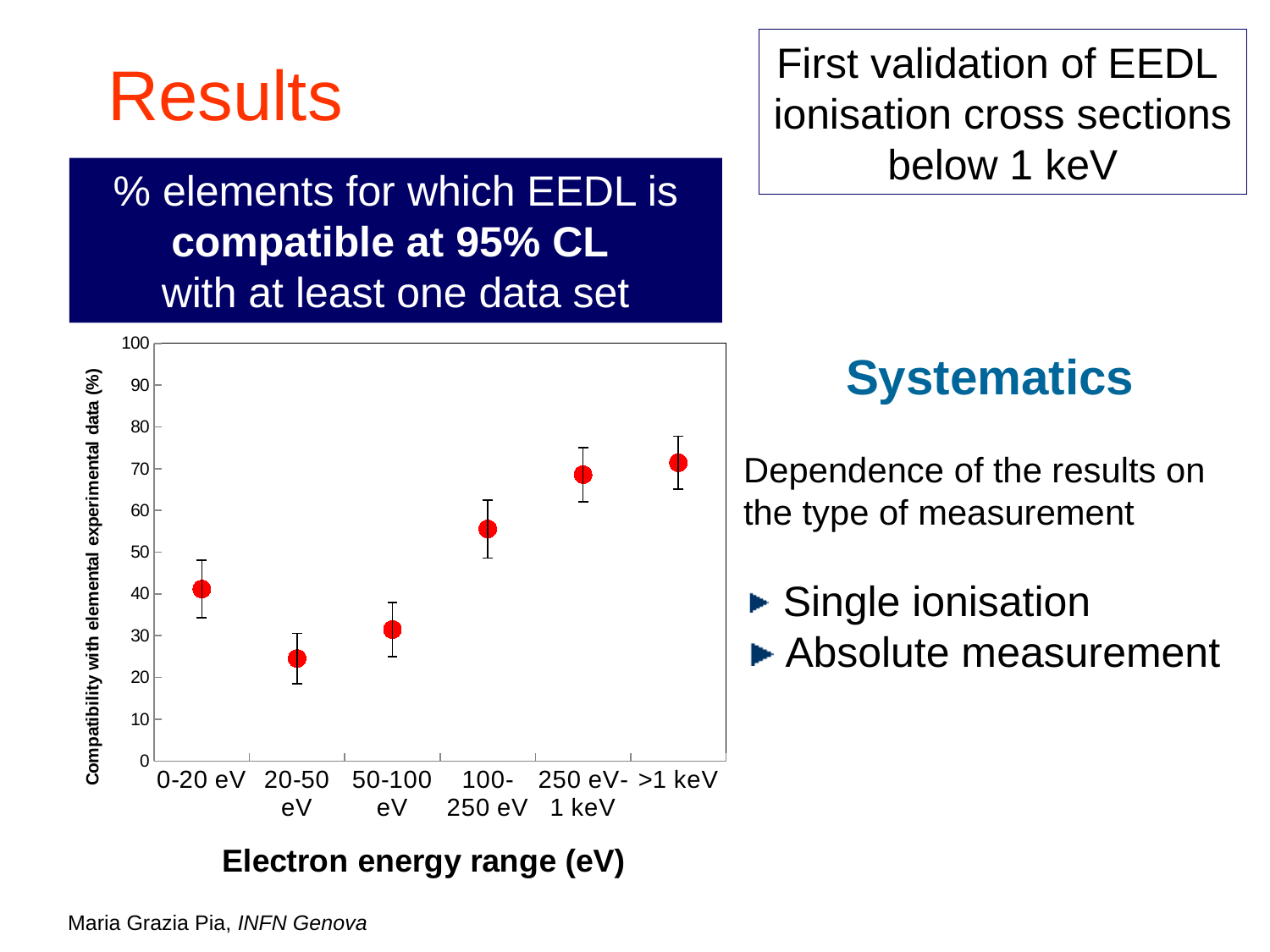
Which electron energy range has the lowest compatibility value? 20-50 eV Is the value for >1 keV greater or less than 60? greater Which has the larger compatibility value, 50-100 eV or 100-250 eV? 100-250 eV Is the value for 20-50 eV greater or less than 30? less Is the value for 0-20 eV greater or less than 50? less What is the title of the x axis of the chart? Electron energy range (eV) How many electron energy range categories are plotted on the x axis? 6 What kind of chart is shown on the slide? Scatter (point) chart with error bars From 20-50 eV to >1 keV, do the plotted values rise or fall along the x axis? rise Which has the larger compatibility value, 0-20 eV or 20-50 eV? 0-20 eV